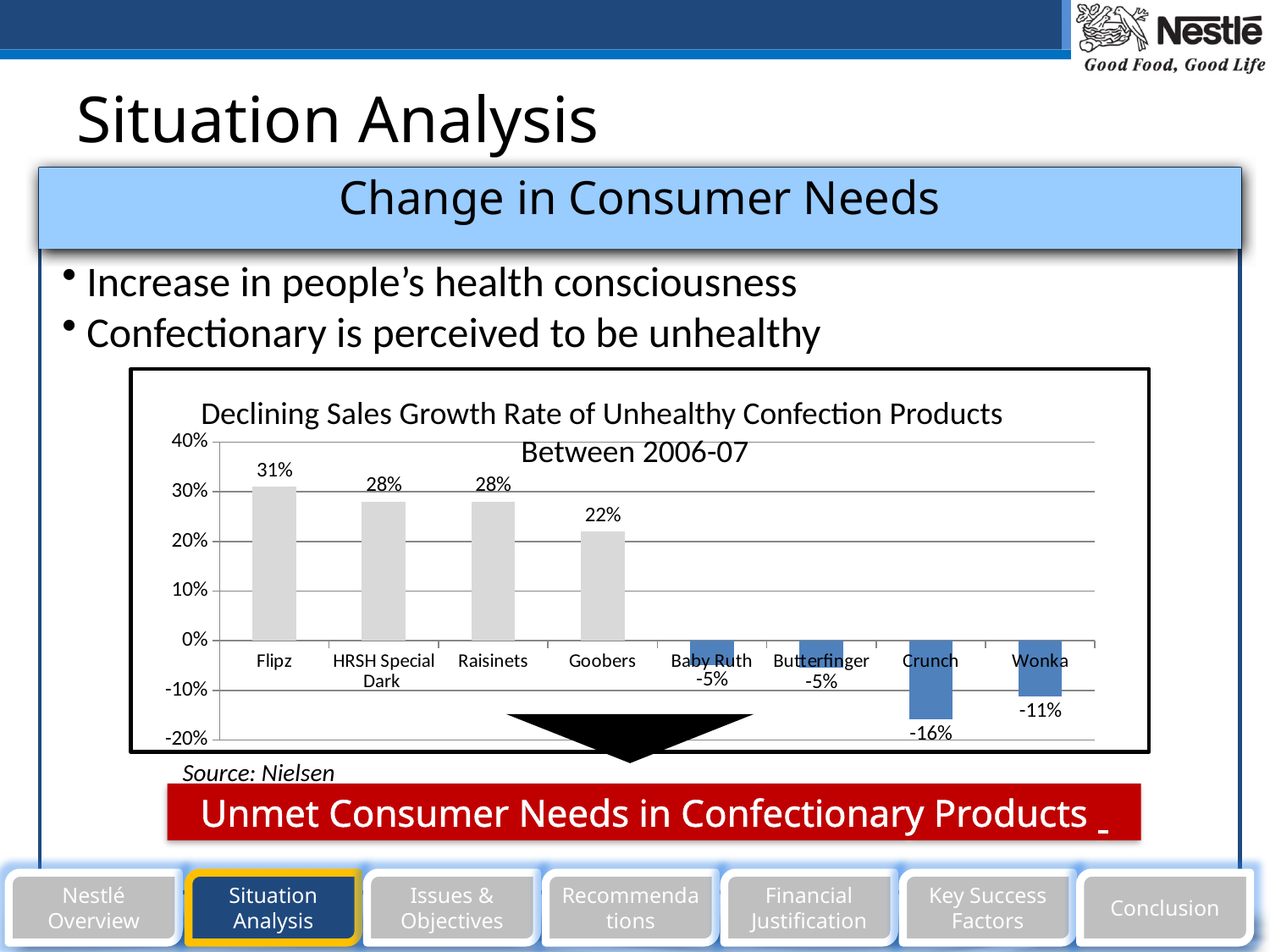
What type of chart is used to show the sales growth rates? Bar chart What is the sales growth rate shown for Goobers? 22% Which product has the highest sales growth rate in the chart? Flipz Which has a higher growth rate, Raisinets or Goobers? Raisinets What is the difference between the growth rates of Flipz and Goobers? 9 percentage points Which product has the lowest sales growth rate in the chart? Crunch What is the sales growth rate shown for Flipz? 31% What is the title of the chart? Declining Sales Growth Rate of Unhealthy Confection Products Between 2006-07 How many products are shown in the chart? 8 What is the sales growth rate shown for Crunch? -16% Do the values rise or fall moving from left to right across the products? Fall What is the sales growth rate shown for Wonka? -11%